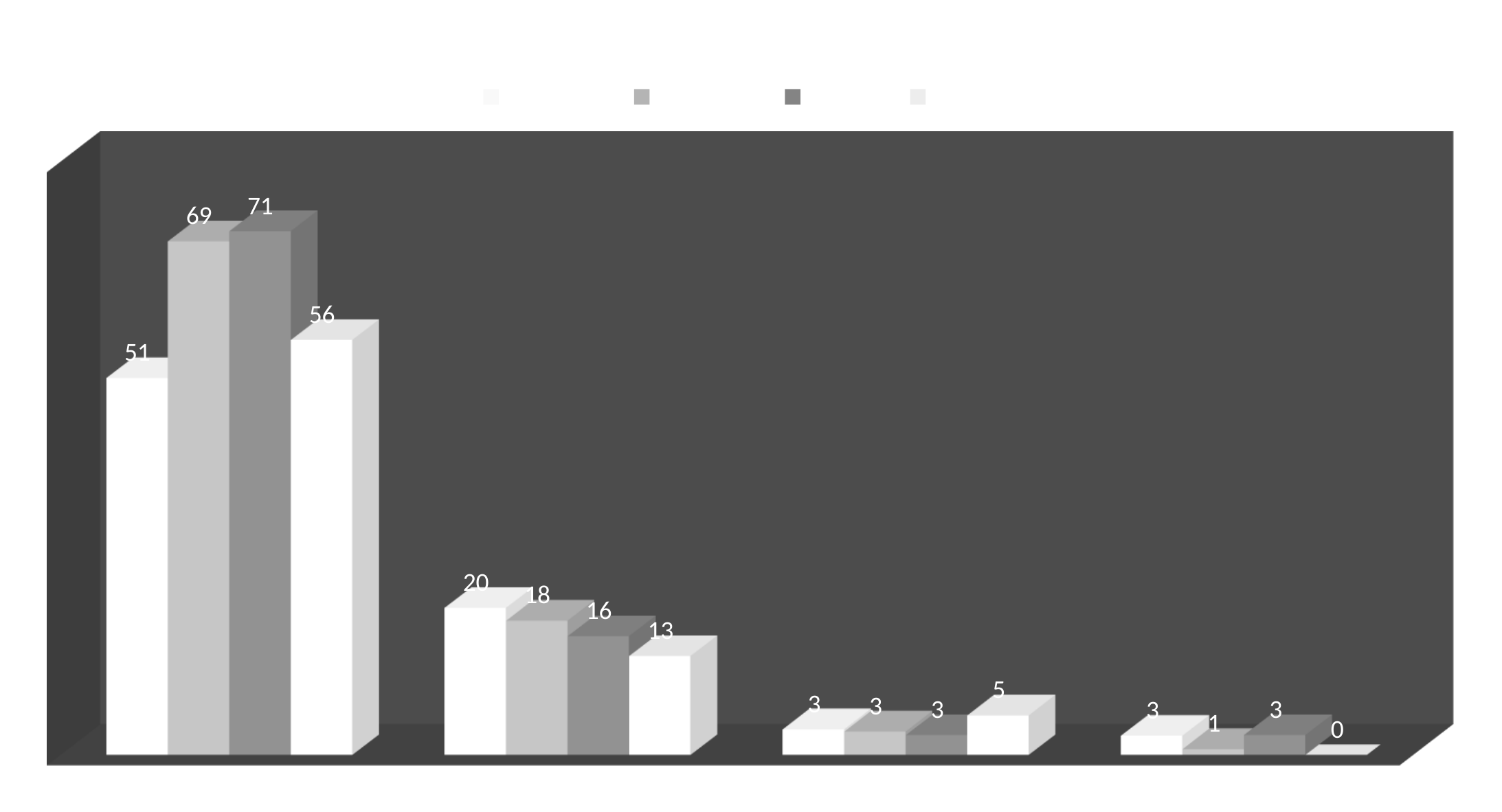
Do the values generally rise or fall moving from the leftmost group to the rightmost group? fall In the second group, which is larger: the first bar or the fourth bar? the first bar (20) What is the value of the fourth bar in the second group? 13 What kind of chart is shown on the slide? bar chart What is the value of the first (leftmost) bar in the first group? 51 How many bars are in each group? 4 What is the highest data label shown on the chart? 71 What is the lowest data label shown on the chart? 0 How many groups of bars are plotted along the x axis? 4 How many series does the legend show? 4 What is the difference between the third bar (71) and the first bar (51) in the first group? 20 What is the value of the fourth bar in the third group? 5